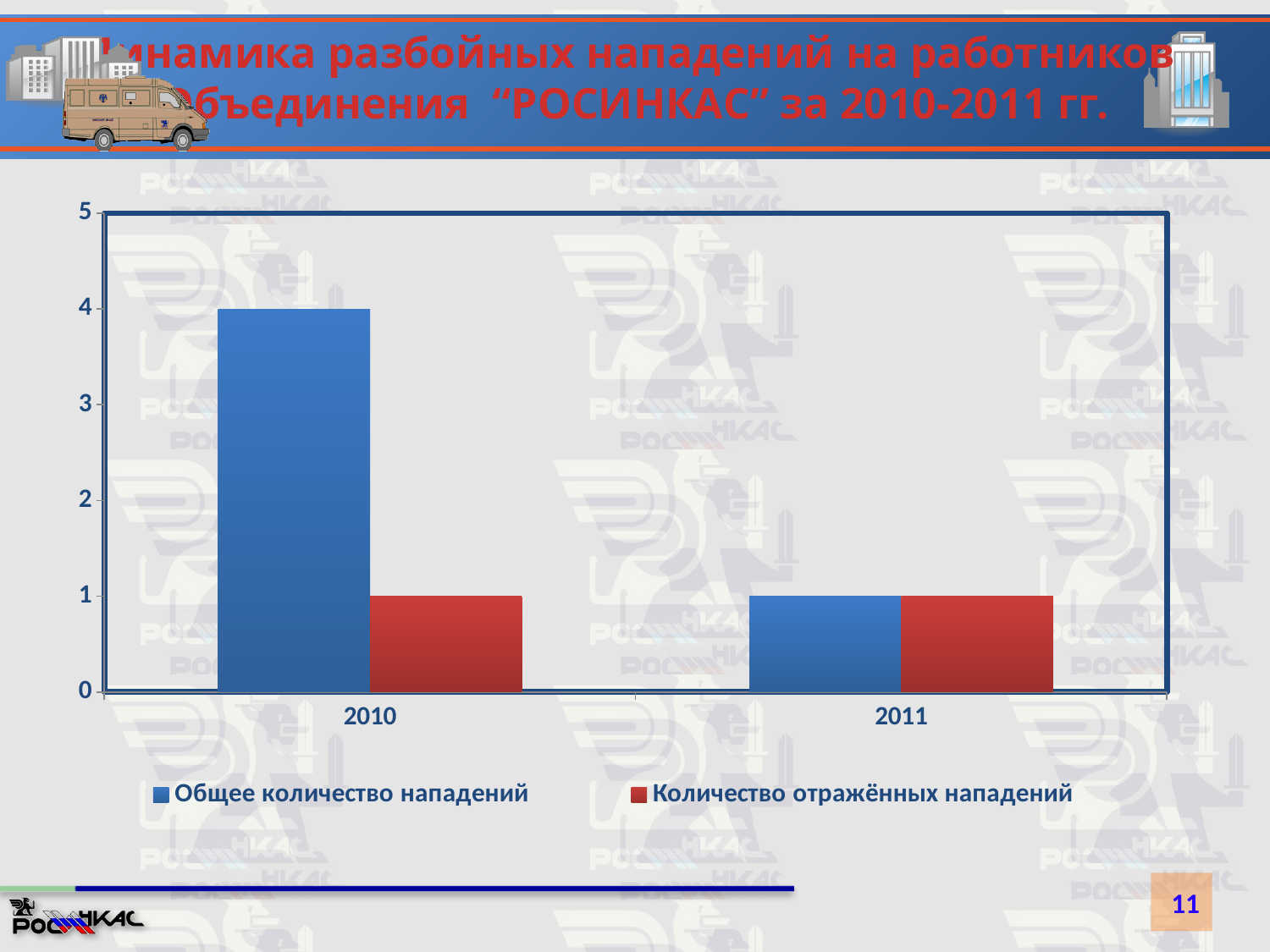
Is the value for "Общее количество нападений" in 2010 greater or less than 3? greater What is the value of "Общее количество нападений" for 2011? 1 What kind of chart is shown on the slide? bar chart Which is larger: "Общее количество нападений" in 2010 or in 2011? 2010 Does "Общее количество нападений" rise or fall from 2010 to 2011? fall Which year has the highest value for "Общее количество нападений"? 2010 What is the value of "Количество отражённых нападений" for 2010? 1 How many series does the legend list? 2 What is the difference between "Общее количество нападений" and "Количество отражённых нападений" in 2010? 3 How many years (categories) are shown on the x axis? 2 What is the value of "Количество отражённых нападений" for 2011? 1 What is the value of "Общее количество нападений" for 2010? 4